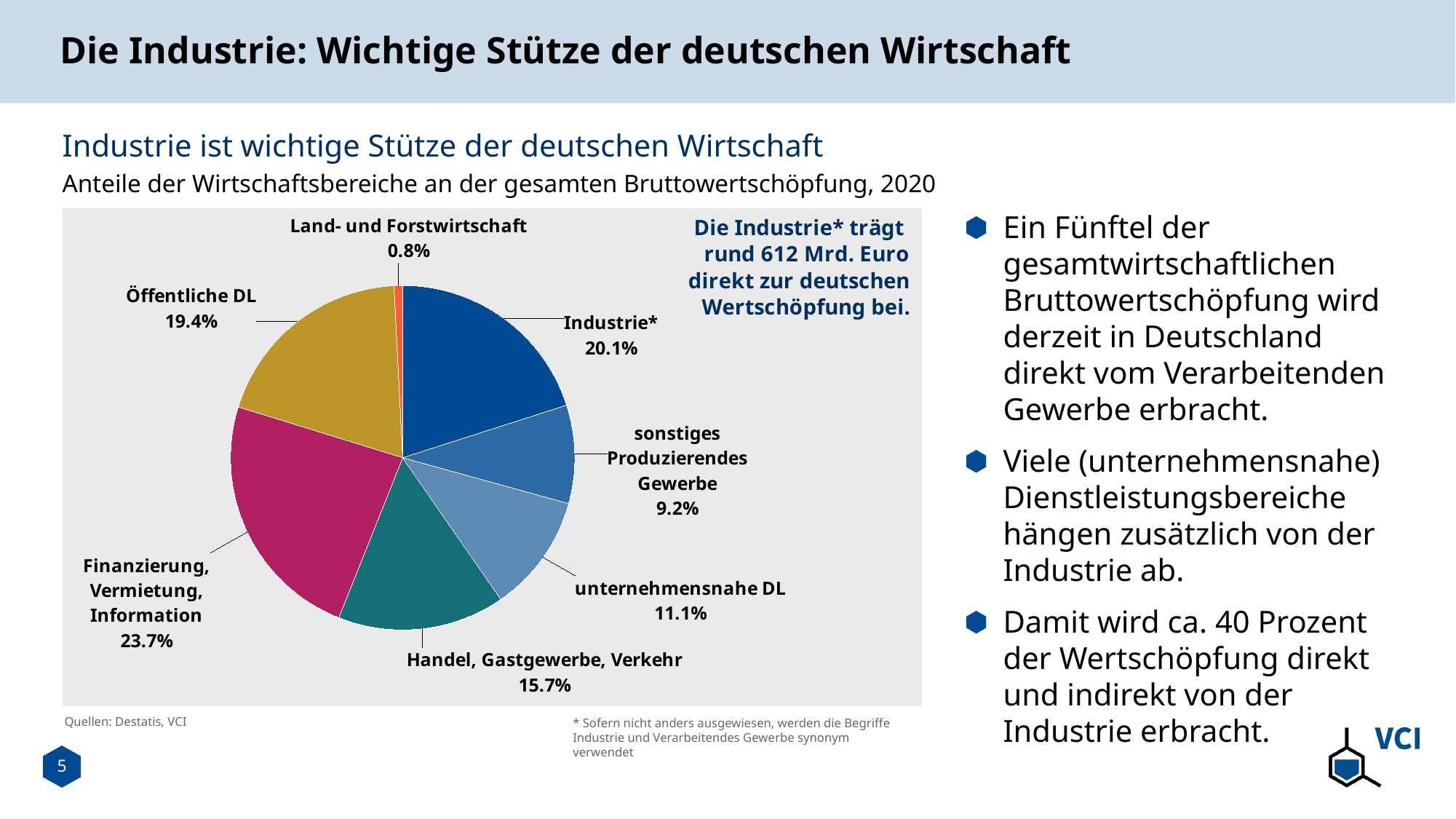
Which sector has the smallest share in the pie chart? Land- und Forstwirtschaft What is the combined share of Industrie* and sonstiges Produzierendes Gewerbe? 29.3% What is the share of Finanzierung, Vermietung, Information? 23.7% What type of chart is shown on the slide? Pie chart What is the difference in percentage points between Industrie* and sonstiges Produzierendes Gewerbe? 10.9 percentage points Which is larger: the share of Öffentliche DL or the share of Industrie*? Industrie* How many sectors are shown in the pie chart? 7 What share is shown for Handel, Gastgewerbe, Verkehr? 15.7% Which sector has the largest share in the pie chart? Finanzierung, Vermietung, Information What share does Industrie* have in the pie chart? 20.1% What is the share of unternehmensnahe DL? 11.1% According to the text box in the chart, how much does Industrie* contribute directly to German value added? rund 612 Mrd. Euro